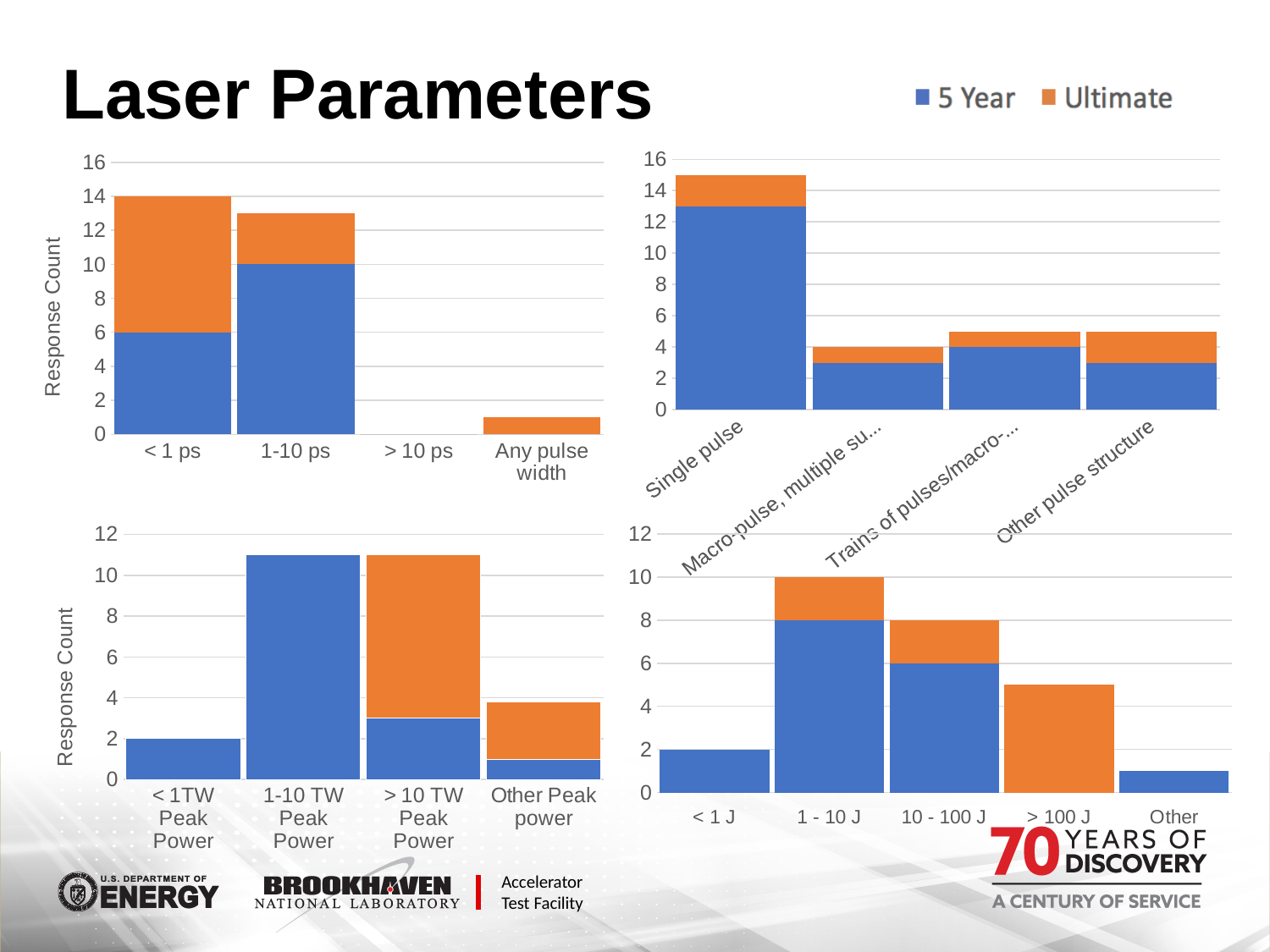
In the bottom-left chart, what is the 5 Year value for < 1TW Peak Power? 2 In the bottom-right chart, what is the 5 Year value for 1 - 10 J? 8 In the top-right chart, is the 5 Year value for Single pulse greater or less than 12? greater In the top-left chart, what is the total stacked height of the < 1 ps bar? 14 What kind of chart is the bottom-right chart? Stacked bar chart In the top-left chart, what is the 5 Year value for 1-10 ps? 10 In the bottom-left chart, is the 5 Year value for 1-10 TW Peak Power greater or less than 10? greater In the top-left chart, what is the 5 Year value for < 1 ps? 6 In the bottom-right chart, what is the difference between the total stacked heights of the 1 - 10 J and 10 - 100 J bars? 2 In the top-left chart, which category has the tallest stacked bar? < 1 ps How many series does the legend list? 2